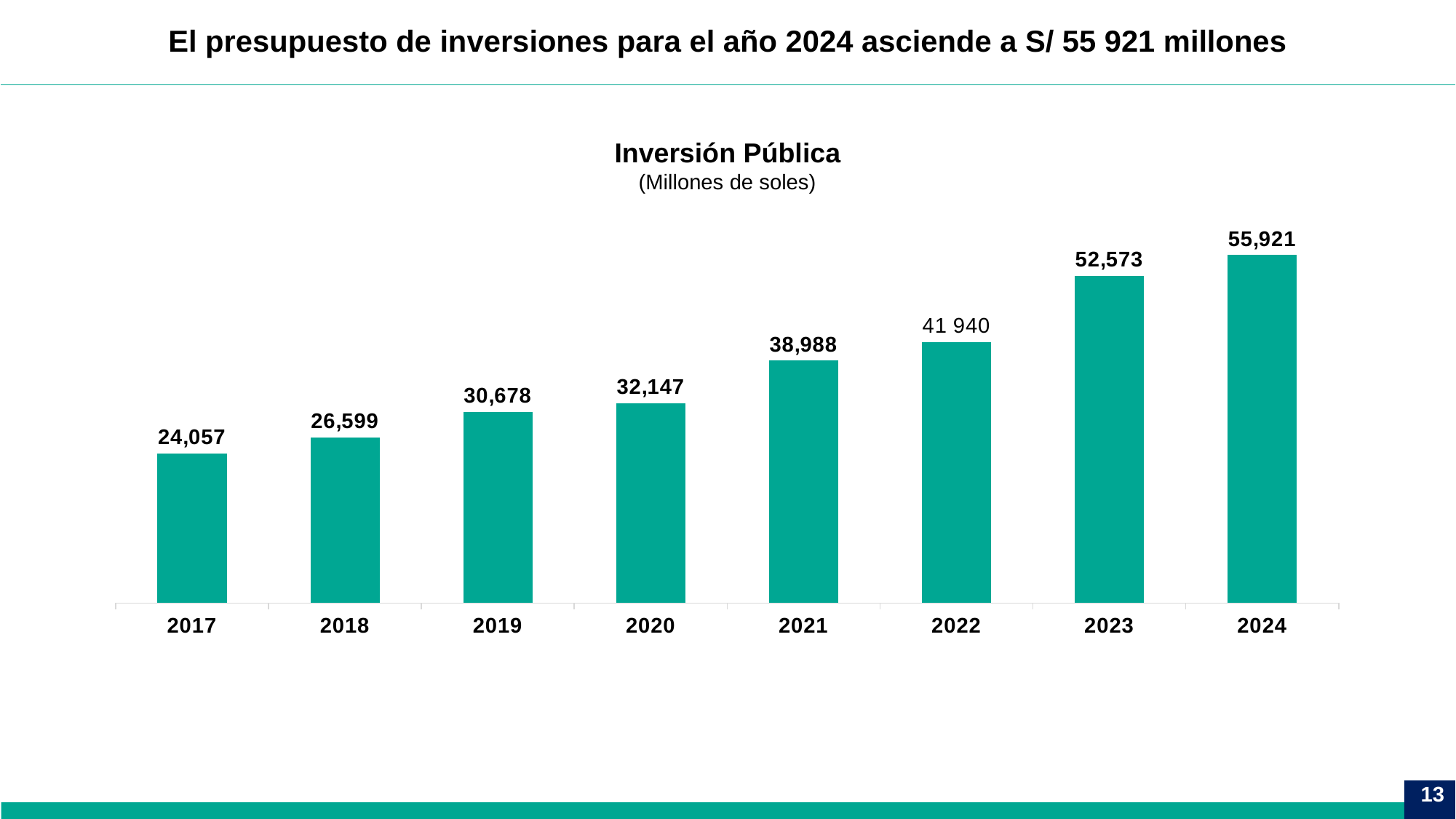
Which year has the lowest value? 2017 What is the value for 2017? 24,057 What is the value for 2024? 55,921 Do the values rise or fall from 2017 to 2024? rise Which year has the highest value? 2024 Which is larger, the value for 2019 or the value for 2020? 2020 What kind of chart is this? bar chart What is the value for 2021? 38,988 How many years are shown on the x axis? 8 What is the difference between the values for 2020 and 2019? 1,469 What is the difference between the values for 2024 and 2023? 3,348 What is the value for 2022? 41 940